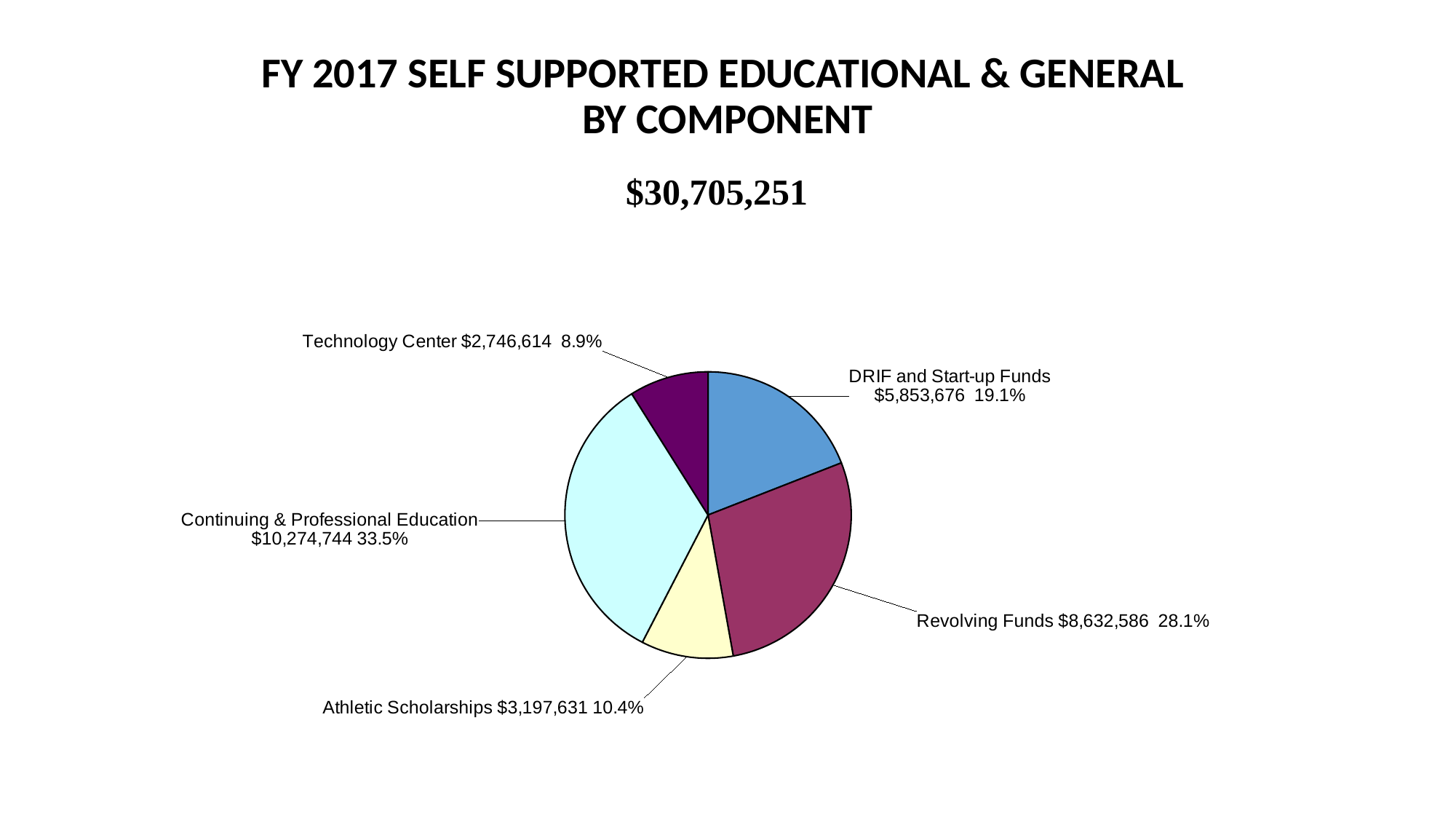
What is the dollar value for Athletic Scholarships? $3,197,631 What type of chart is shown on the slide? Pie chart Which component has the smallest share of the pie? Technology Center What is the dollar value for Continuing & Professional Education? $10,274,744 What total amount is shown below the chart title? $30,705,251 What is the difference in dollars between Revolving Funds and Athletic Scholarships? $5,434,955 What percentage share does Revolving Funds have? 28.1% Which component has the largest share of the pie? Continuing & Professional Education How many components (slices) are shown in the pie chart? 5 What is the dollar value for DRIF and Start-up Funds? $5,853,676 Which is larger, Athletic Scholarships or DRIF and Start-up Funds? DRIF and Start-up Funds What percentage share does Technology Center have? 8.9%